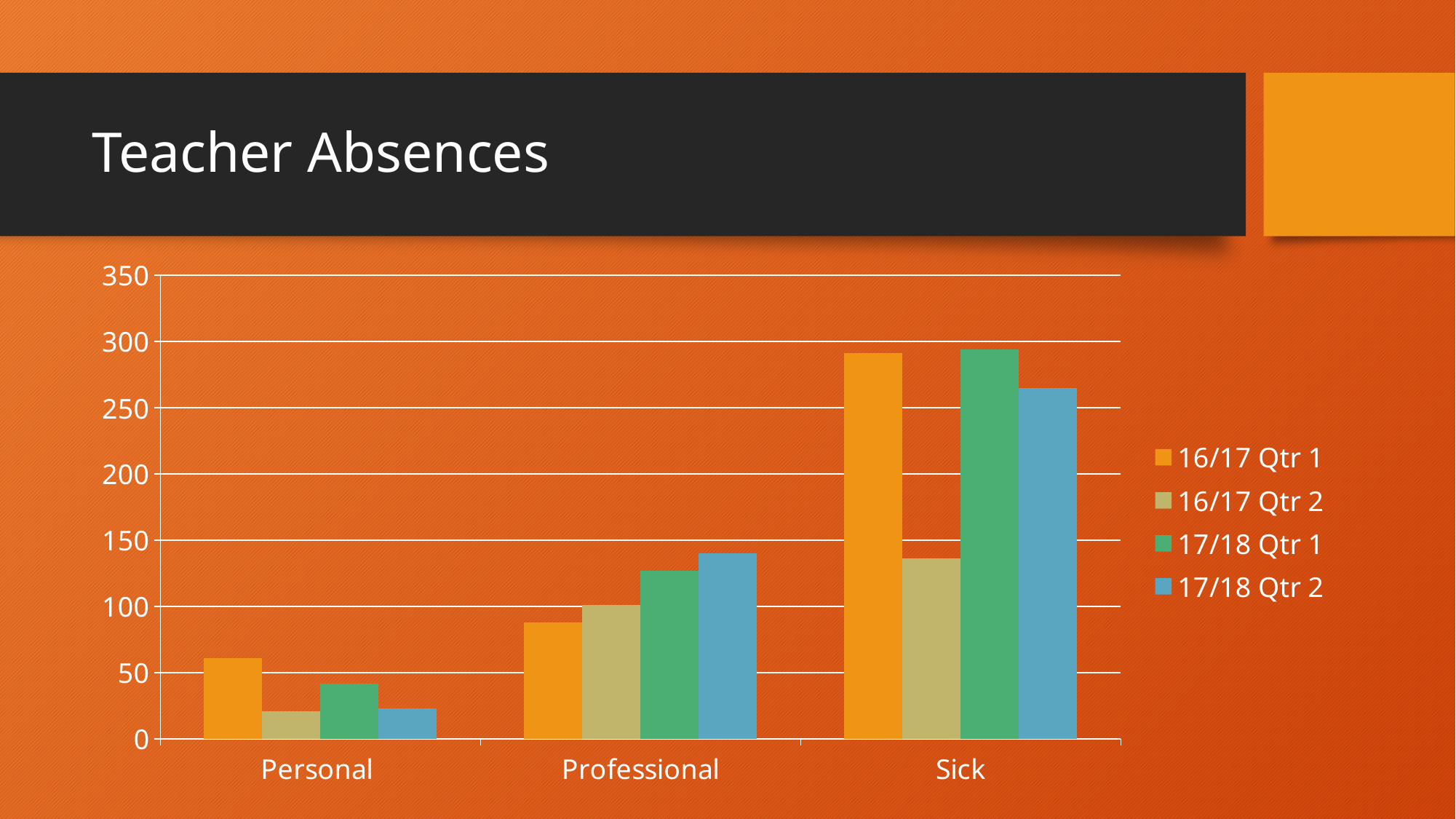
Is the value for 17/18 Qtr 2 in the Sick category greater or less than 250? greater Is the value for 17/18 Qtr 2 in the Professional category greater or less than 150? less Which category has the lowest value for the 17/18 Qtr 2 series? Personal What is the title of the slide containing the chart? Teacher Absences Do the values for the 17/18 Qtr 2 series rise or fall moving from Personal to Professional to Sick? rise How many categories are shown on the x axis of the chart? 3 What kind of chart is shown on the slide? bar chart Is the value for 16/17 Qtr 2 in the Sick category greater or less than 150? less In the Personal category, which is larger: 16/17 Qtr 1 or 17/18 Qtr 1? 16/17 Qtr 1 How many series does the chart's legend list? 4 Within the Sick category, which series has the lowest value? 16/17 Qtr 2 Which category has the highest value for the 16/17 Qtr 1 series? Sick